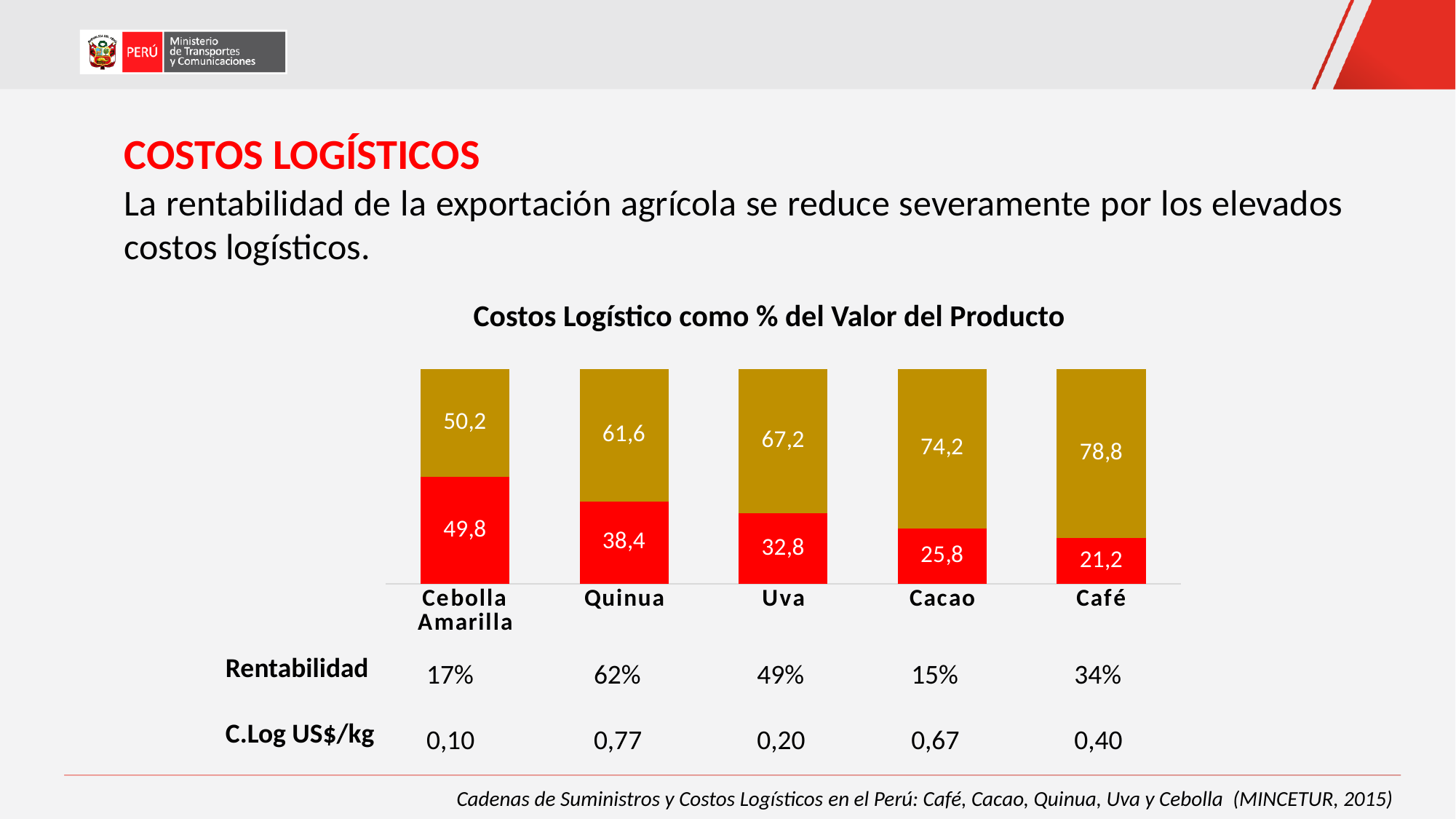
What is the title of the chart? Costos Logístico como % del Valor del Producto How many product categories are shown in the chart? 5 What is the value of the red segment for Cebolla Amarilla? 49,8 Which is larger: the red segment for Quinua or the red segment for Cacao? Quinua What kind of chart is shown on the slide? stacked bar chart What is the value of the red segment for Uva? 32,8 What is the difference between the gold segment values of Café and Cebolla Amarilla? 28,6 Do the red segment values rise or fall from Cebolla Amarilla to Café along the x axis? fall Which category has the highest red segment value? Cebolla Amarilla Which category has the lowest red segment value? Café What is the total of the stacked bar for Quinua? 100 What is the value of the gold segment for Café? 78,8